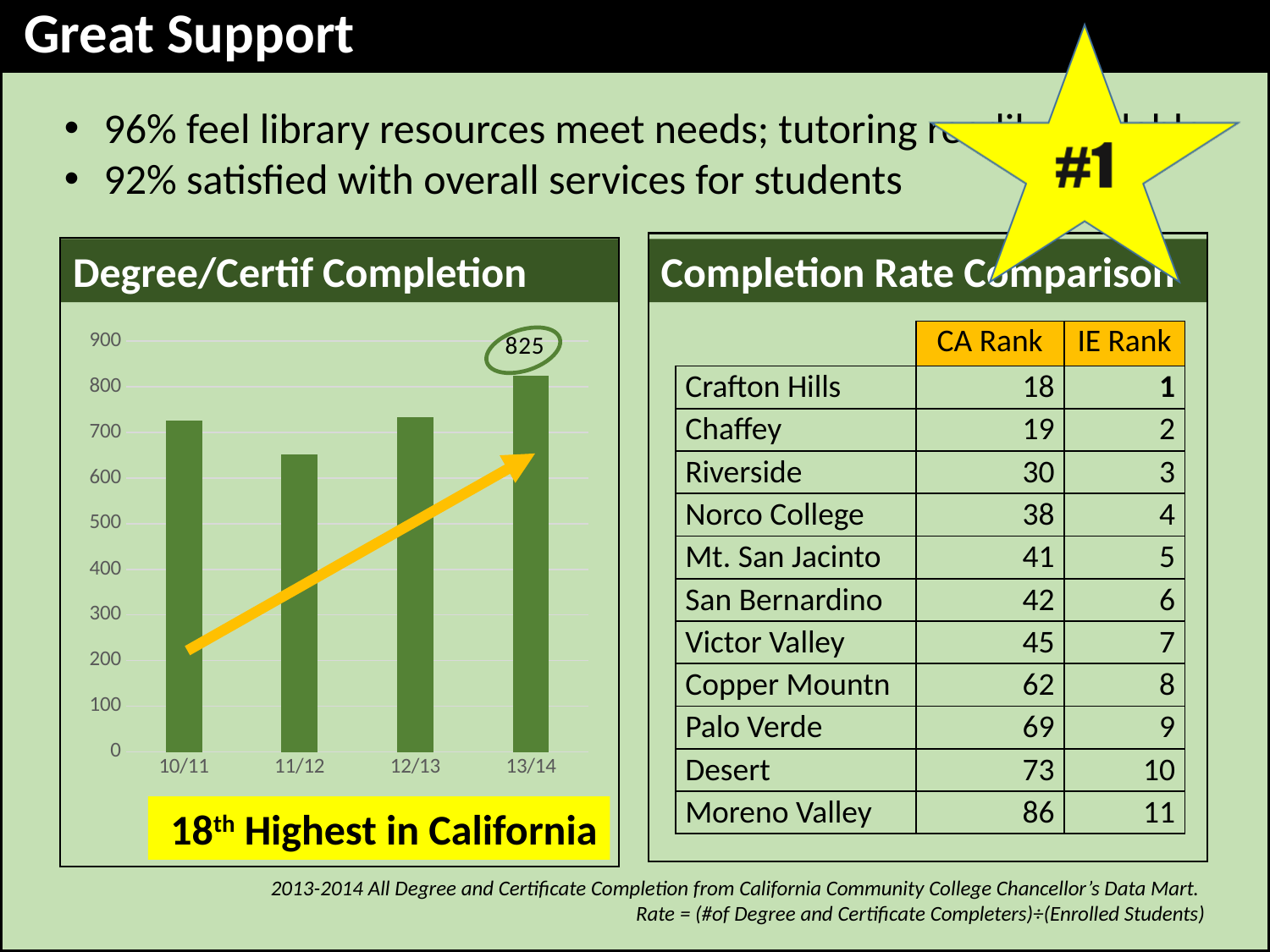
In the Degree/Certif Completion chart, which is larger, the value for 11/12 or the value for 13/14? 13/14 Which year has the highest value in the Degree/Certif Completion chart? 13/14 In the Degree/Certif Completion chart, is the value for 12/13 greater or less than 800? less Which year has the lowest value in the Degree/Certif Completion chart? 11/12 In the Degree/Certif Completion chart, is the value for 11/12 greater or less than 700? less In the Degree/Certif Completion chart, do the values rise or fall from 11/12 to 13/14? rise What is the title of the bar chart on the slide? Degree/Certif Completion In the Degree/Certif Completion chart, is the value for 10/11 greater or less than 600? greater What is the value for 13/14 in the Degree/Certif Completion chart? 825 What is the highest value shown on the y axis of the Degree/Certif Completion chart? 900 What kind of chart is the Degree/Certif Completion chart? bar chart How many years are shown on the x axis of the Degree/Certif Completion chart? 4